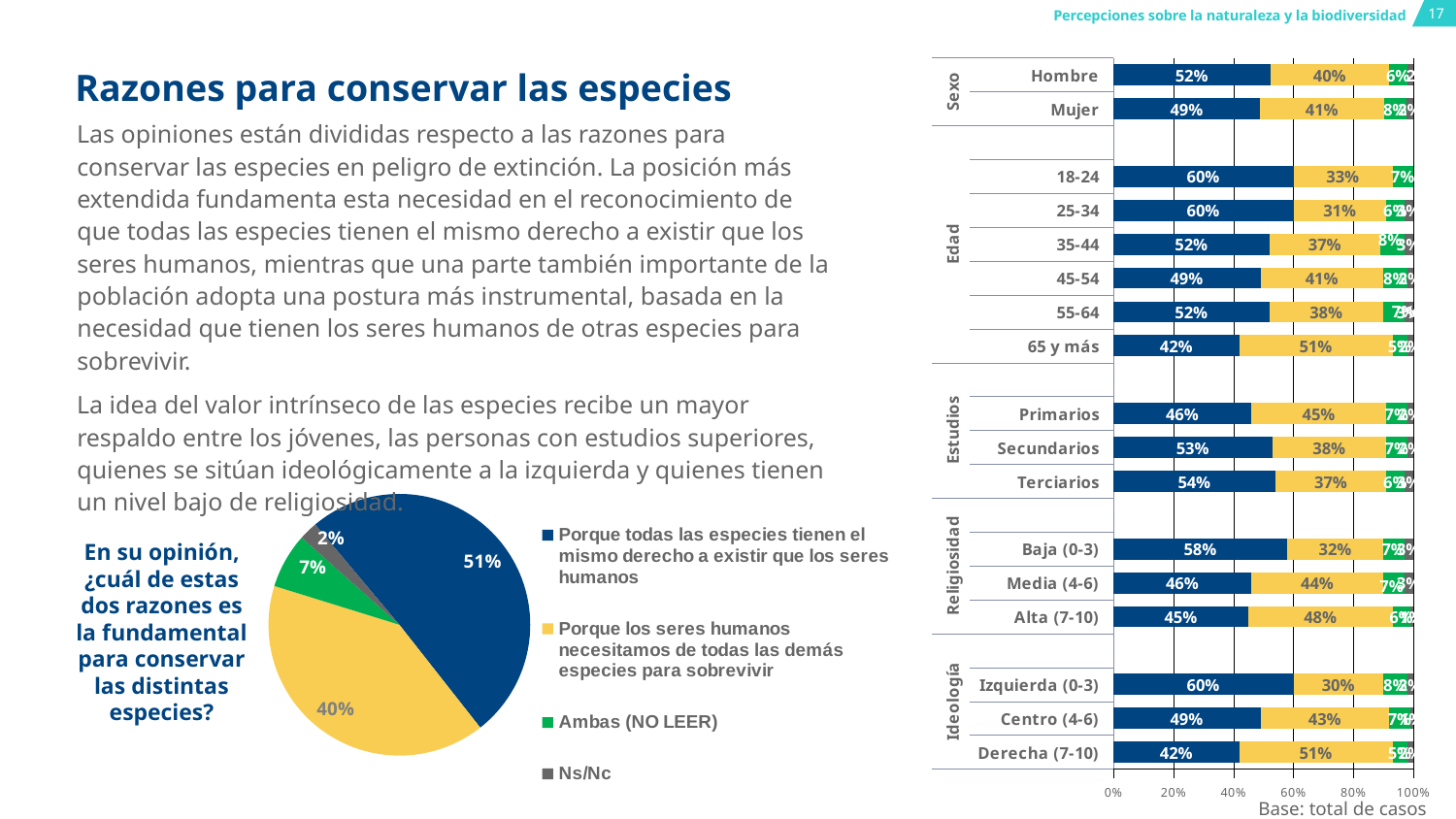
In the pie chart on the left, which legend entry corresponds to the largest slice? Porque todas las especies tienen el mismo derecho a existir que los seres humanos In the bar chart on the right, which of the Edad groups has the lowest blue segment value? 65 y más In the bar chart on the right, what is the difference between the blue segment for '18-24' and the blue segment for '65 y más'? 18 percentage points In the pie chart on the left, what share is shown for 'Ambas (NO LEER)'? 7% How many entries does the legend of the pie chart on the left list? 4 In the bar chart on the right, what is the value of the yellow segment for 'Hombre'? 40% In the bar chart on the right, what is the value of the blue segment for 'Izquierda (0-3)'? 60% In the pie chart on the left, what is the difference between the 51% slice and the 40% slice? 11 percentage points What kind of chart is the chart on the right of the slide, broken down by Sexo, Edad, Estudios, Religiosidad and Ideología? Bar chart In the bar chart on the right, what is the value of the yellow segment for '65 y más'? 51% In the bar chart on the right, which has the larger blue segment, 'Baja (0-3)' or 'Alta (7-10)'? Baja (0-3) What kind of chart is the chart on the left of the slide, next to the question 'En su opinión, ¿cuál de estas dos razones es la fundamental para conservar las distintas especies?'? Pie chart